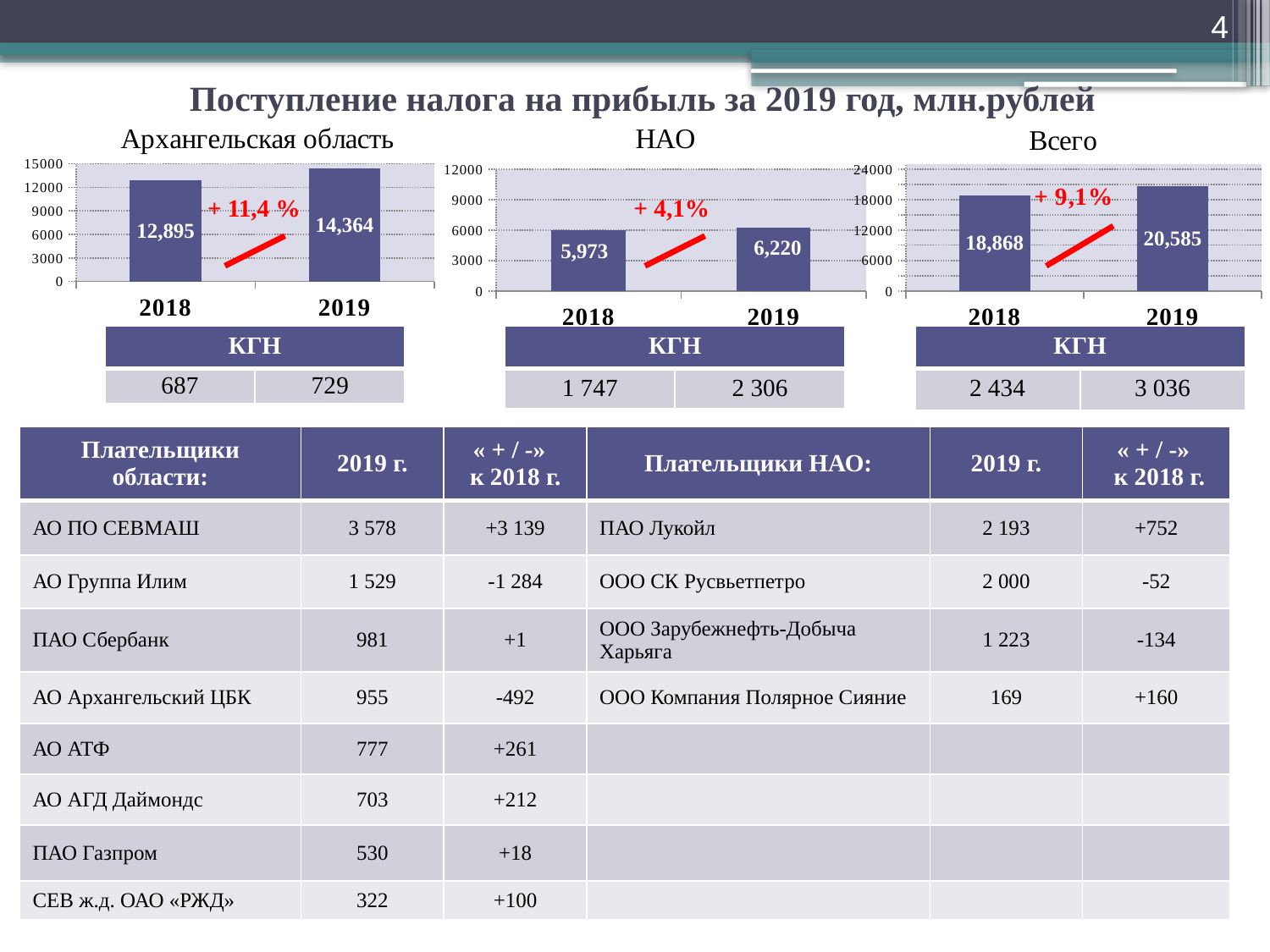
In the Архангельская область chart, what is the difference between the 2019 and 2018 values? 1,469 In the Архангельская область chart, what is the value for 2019? 14,364 In the Всего chart, what is the value for 2018? 18,868 In the Архангельская область chart, what is the value for 2018? 12,895 In the НАО chart, do the values rise or fall from 2018 to 2019? rise In the НАО chart, what is the value for 2019? 6,220 In the Всего chart, which year has the higher value? 2019 What type of chart is the Всего chart? bar chart In the НАО chart, what is the value for 2018? 5,973 What percentage change is annotated on the Всего chart? + 9,1% In the НАО chart, what is the difference between the 2019 and 2018 values? 247 In the Всего chart, what is the value for 2019? 20,585